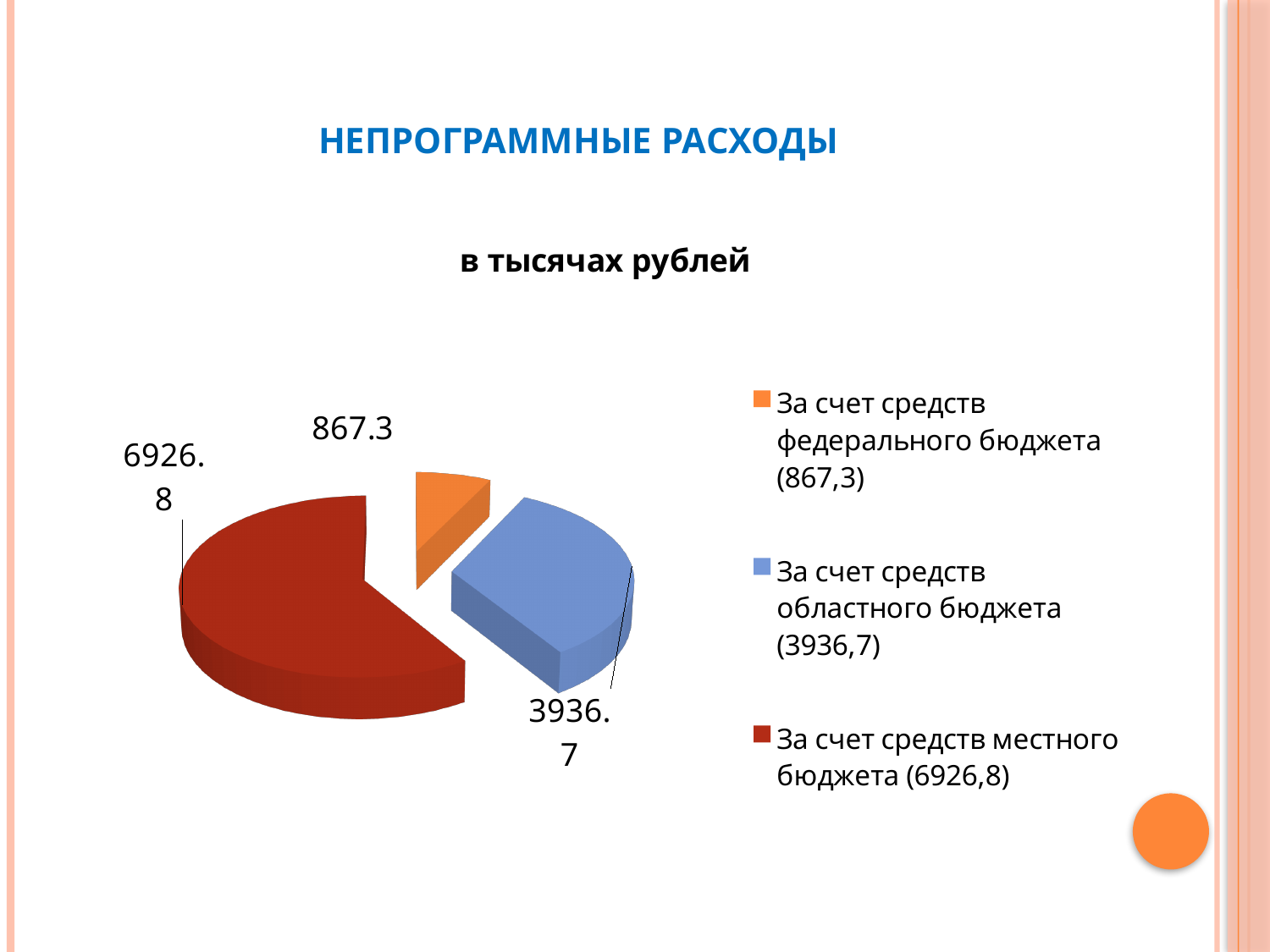
What is the total of all three slices? 11730.8 Which is larger: the value for the regional budget or the value for the federal budget? regional budget (3936.7) What is the value for 'За счет средств федерального бюджета'? 867.3 What is the difference between the regional budget value (3936.7) and the federal budget value (867.3)? 3069.4 Which category has the smallest slice of the pie? За счет средств федерального бюджета What is the title of the chart? в тысячах рублей Which category has the largest slice of the pie? За счет средств местного бюджета What is the value for 'За счет средств местного бюджета'? 6926.8 What type of chart is shown on the slide? pie chart What is the value for 'За счет средств областного бюджета'? 3936.7 How many slices does the pie chart have? 3 What is the difference between the local budget value (6926.8) and the regional budget value (3936.7)? 2990.1